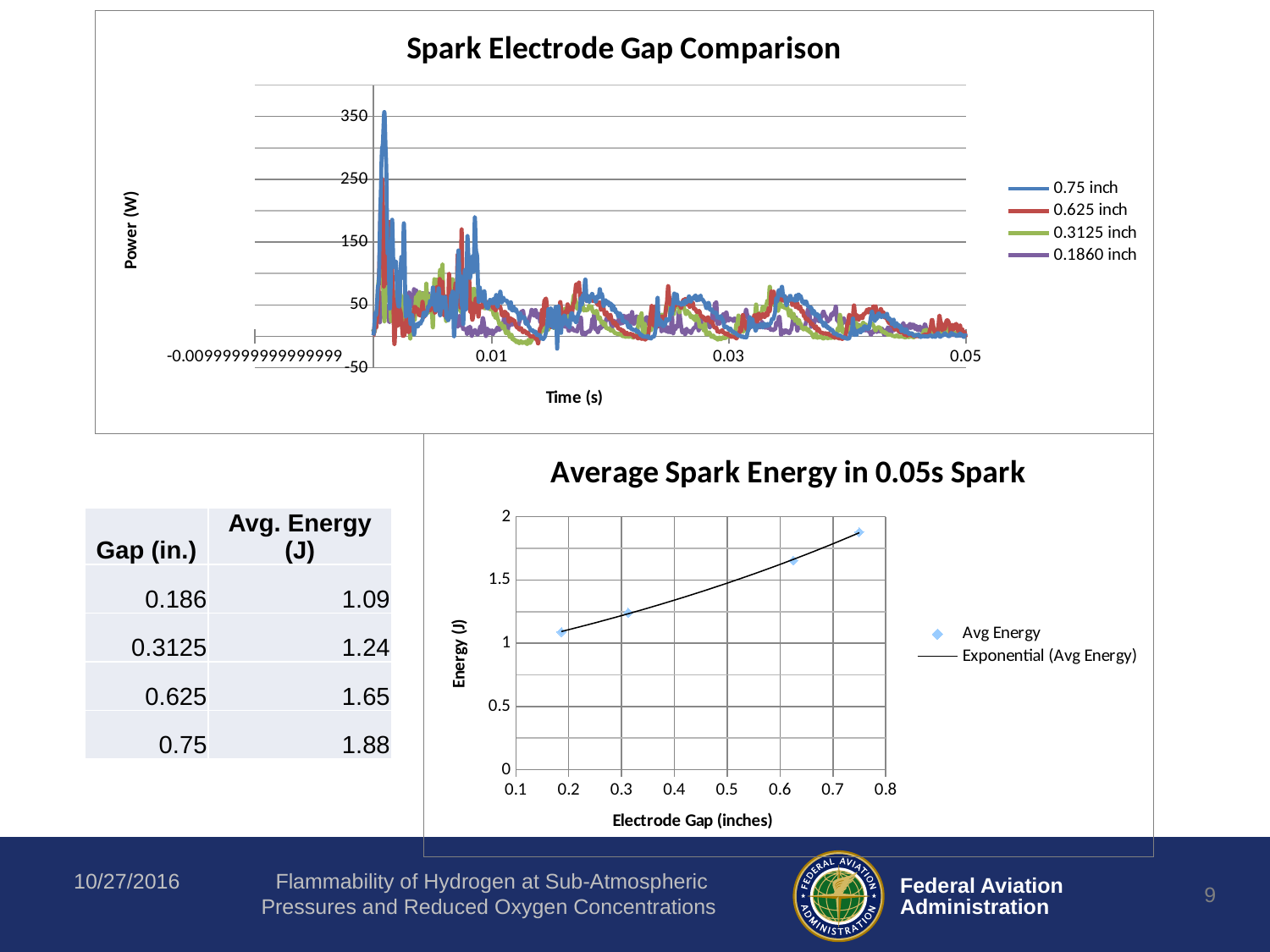
In the 'Spark Electrode Gap Comparison' chart, do the power values generally rise or fall as time increases from 0.01 to 0.05 s? fall In the 'Average Spark Energy in 0.05s Spark' chart, how many data points are plotted? 4 In the 'Spark Electrode Gap Comparison' chart, how many series does the legend list? 4 In the 'Spark Electrode Gap Comparison' chart, what is the label on the y axis? Power (W) In the 'Spark Electrode Gap Comparison' chart, which series is drawn in purple? 0.1860 inch In the 'Average Spark Energy in 0.05s Spark' chart, what is the difference in average energy between the 0.75 inch gap and the 0.625 inch gap? 0.23 In the 'Average Spark Energy in 0.05s Spark' chart, what is the average energy for an electrode gap of 0.75 inches? 1.88 In the 'Average Spark Energy in 0.05s Spark' chart, does average energy rise or fall as the electrode gap increases? rise In the 'Average Spark Energy in 0.05s Spark' chart, which electrode gap has the lowest average energy? 0.186 In the 'Average Spark Energy in 0.05s Spark' chart, what is the average energy for an electrode gap of 0.186 inches? 1.09 In the 'Spark Electrode Gap Comparison' chart, is the peak value of the 0.75 inch series greater or less than 250? greater In the 'Average Spark Energy in 0.05s Spark' chart, which electrode gap has the highest average energy? 0.75